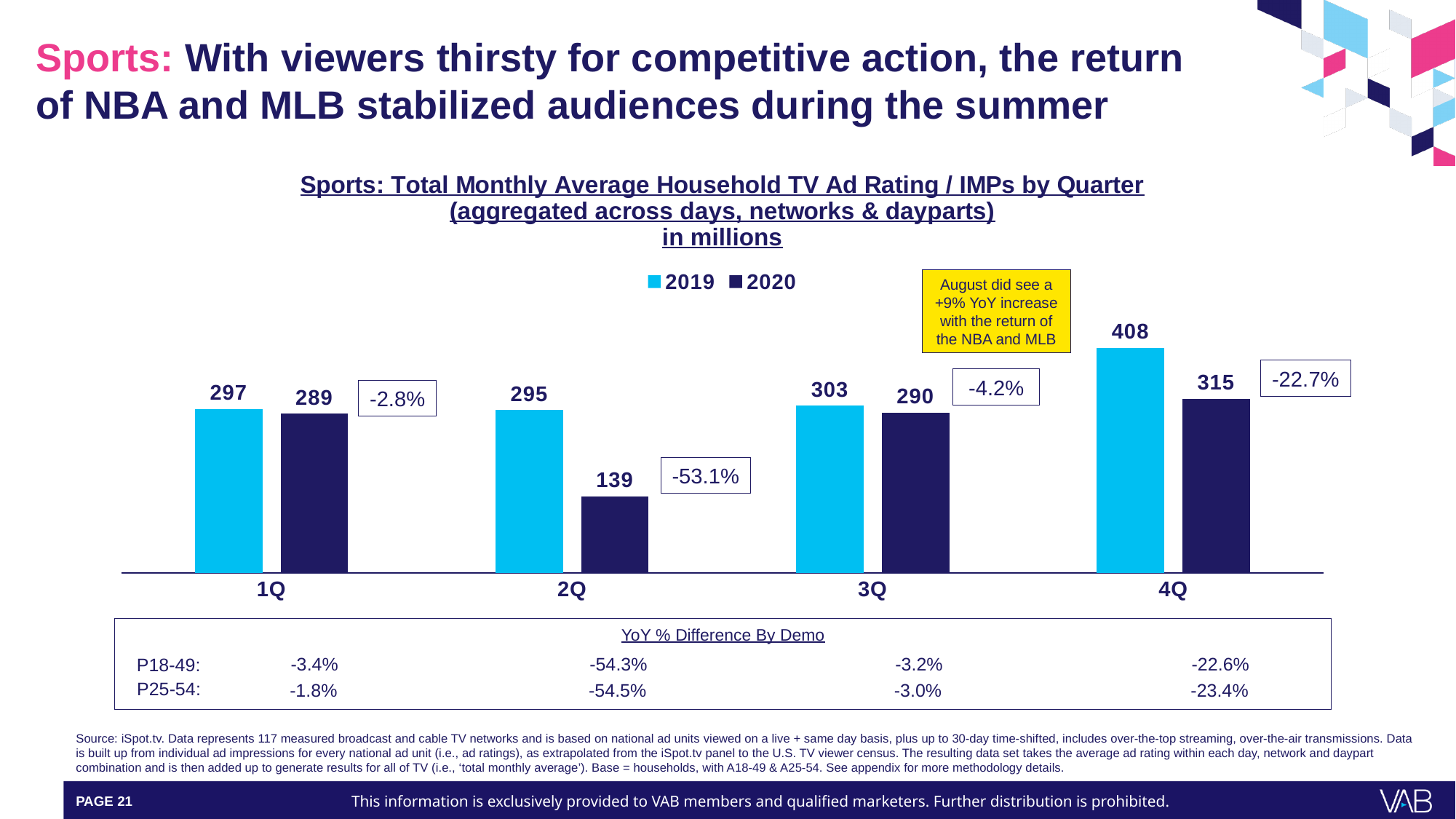
How many quarters are shown on the x axis? 4 Which is larger, the 2019 value for 3Q or the 2020 value for 3Q? 2019 value for 3Q What is the difference between the 2019 and 2020 values for 4Q? 93 What kind of chart is shown? Bar chart Which quarter has the highest 2019 value? 4Q What is the 2019 value for 1Q? 297 What is the 2020 value for 2Q? 139 What YoY percentage change is shown next to the 2Q bars? -53.1% Which quarter has the lowest 2020 value? 2Q How many series does the legend list? 2 What is the difference between the 2019 and 2020 values for 2Q? 156 What is the 2020 value for 4Q? 315